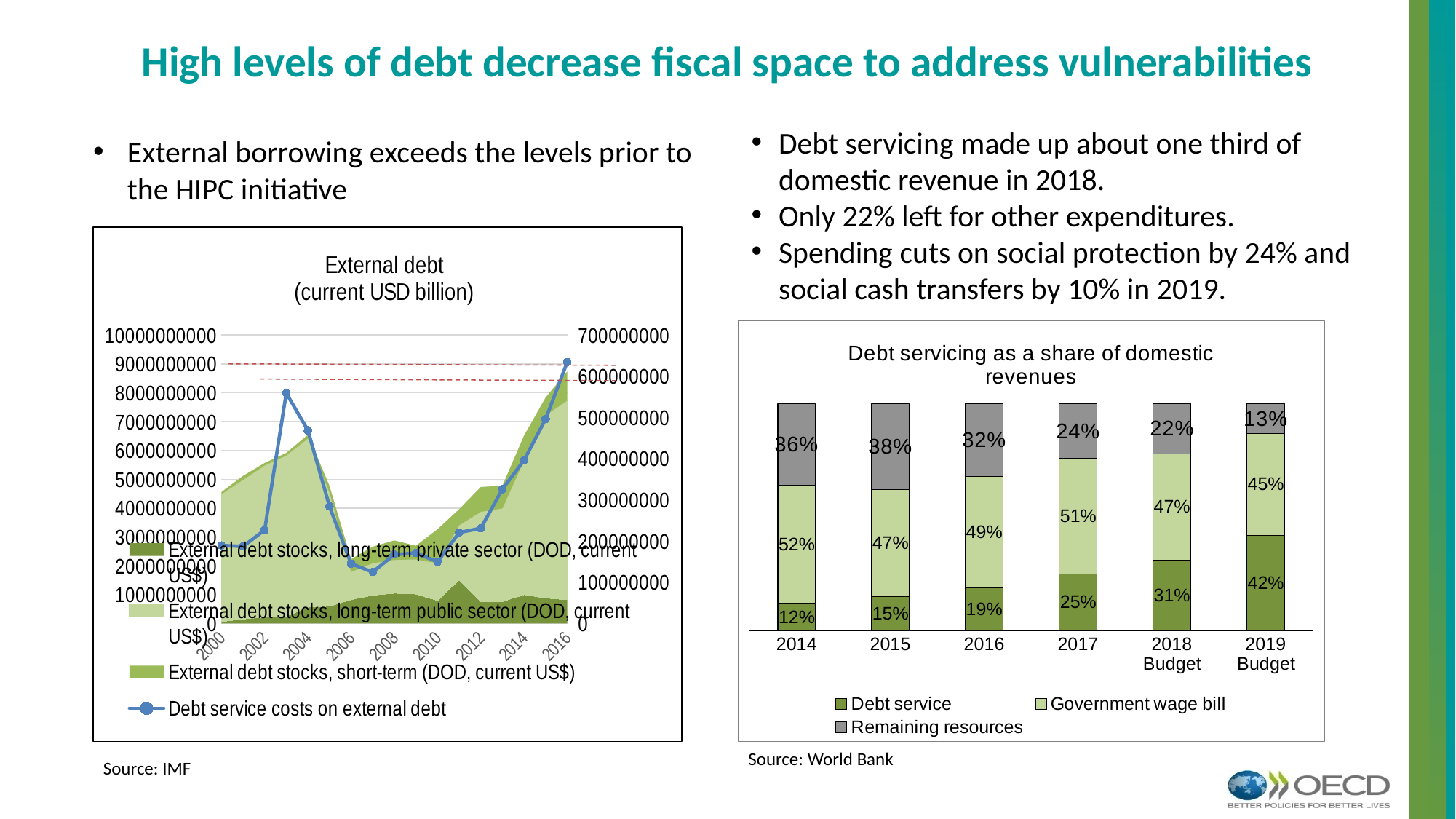
In the 'Debt servicing as a share of domestic revenues' chart, what is the Remaining resources share in the 2019 Budget? 13% In the 'Debt servicing as a share of domestic revenues' chart, which year has the highest Debt service share? 2019 Budget In the 'Debt servicing as a share of domestic revenues' chart, what is the Government wage bill share in 2017? 51% In the 'Debt servicing as a share of domestic revenues' chart, does the Debt service share rise or fall from 2014 to the 2019 Budget? Rise What kind of chart is 'Debt servicing as a share of domestic revenues'? Stacked bar chart In the 'Debt servicing as a share of domestic revenues' chart, what is the difference between the Debt service share in the 2018 Budget and in 2014? 19% In the 'Debt servicing as a share of domestic revenues' chart, how many years are shown on the x axis? 6 In the 'Debt servicing as a share of domestic revenues' chart, how many series does the legend list? 3 In the 'Debt servicing as a share of domestic revenues' chart, which year has the lowest Remaining resources share? 2019 Budget In the 'Debt servicing as a share of domestic revenues' chart, what is the Debt service share in 2014? 12% In the 'Debt servicing as a share of domestic revenues' chart, is the Remaining resources share larger in 2015 or in 2016? 2015 In the 'External debt (current USD billion)' chart, how many series does the legend list? 4